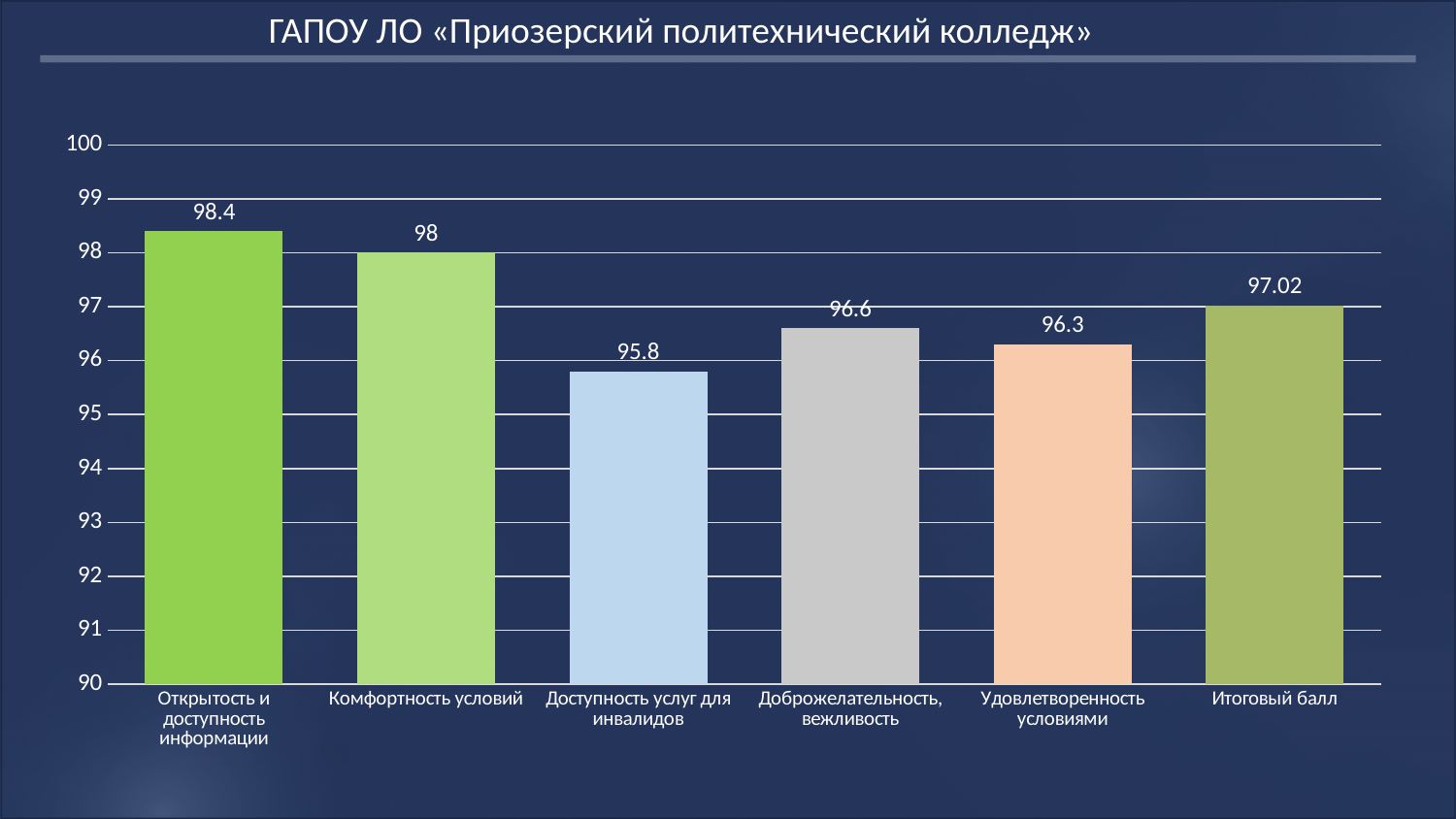
Which category has the lowest value? Доступность услуг для инвалидов What is the title of the slide? ГАПОУ ЛО «Приозерский политехнический колледж» What is the difference between the values for Доброжелательность, вежливость and Удовлетворенность условиями? 0.3 What is the value for Открытость и доступность информации? 98.4 How many categories are shown on the chart? 6 Which category has the highest value? Открытость и доступность информации What kind of chart is shown on the slide? bar chart What is the value for Итоговый балл? 97.02 Which is larger, the value for Комфортность условий or the value for Итоговый балл? Комфортность условий Is the value for Удовлетворенность условиями greater or less than 97? less What is the value for Доступность услуг для инвалидов? 95.8 What is the difference between the values for Открытость и доступность информации and Комфортность условий? 0.4